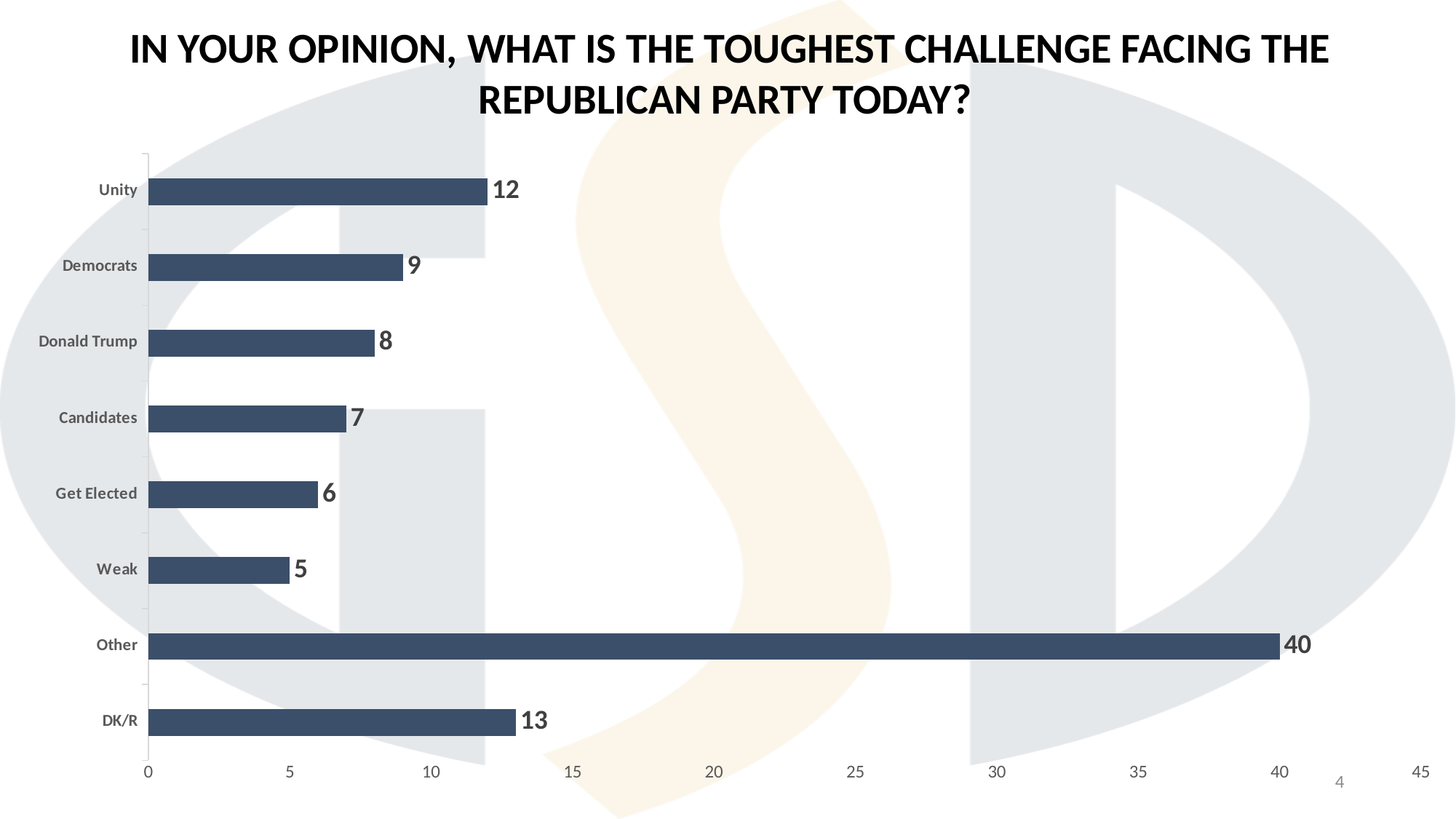
What is the value for Unity? 12 What is the difference between the values for Other and DK/R? 27 How many categories are shown in the chart? 8 What is the difference between the values for Unity and Democrats? 3 Which is larger, the value for Candidates or the value for Get Elected? Candidates Which category has the highest value? Other What is the value for Donald Trump? 8 What kind of chart is shown on the slide? bar chart What is the title of the chart? IN YOUR OPINION, WHAT IS THE TOUGHEST CHALLENGE FACING THE REPUBLICAN PARTY TODAY? What is the value for DK/R? 13 Which category has the lowest value? Weak Is the value for Other greater or less than 35? greater